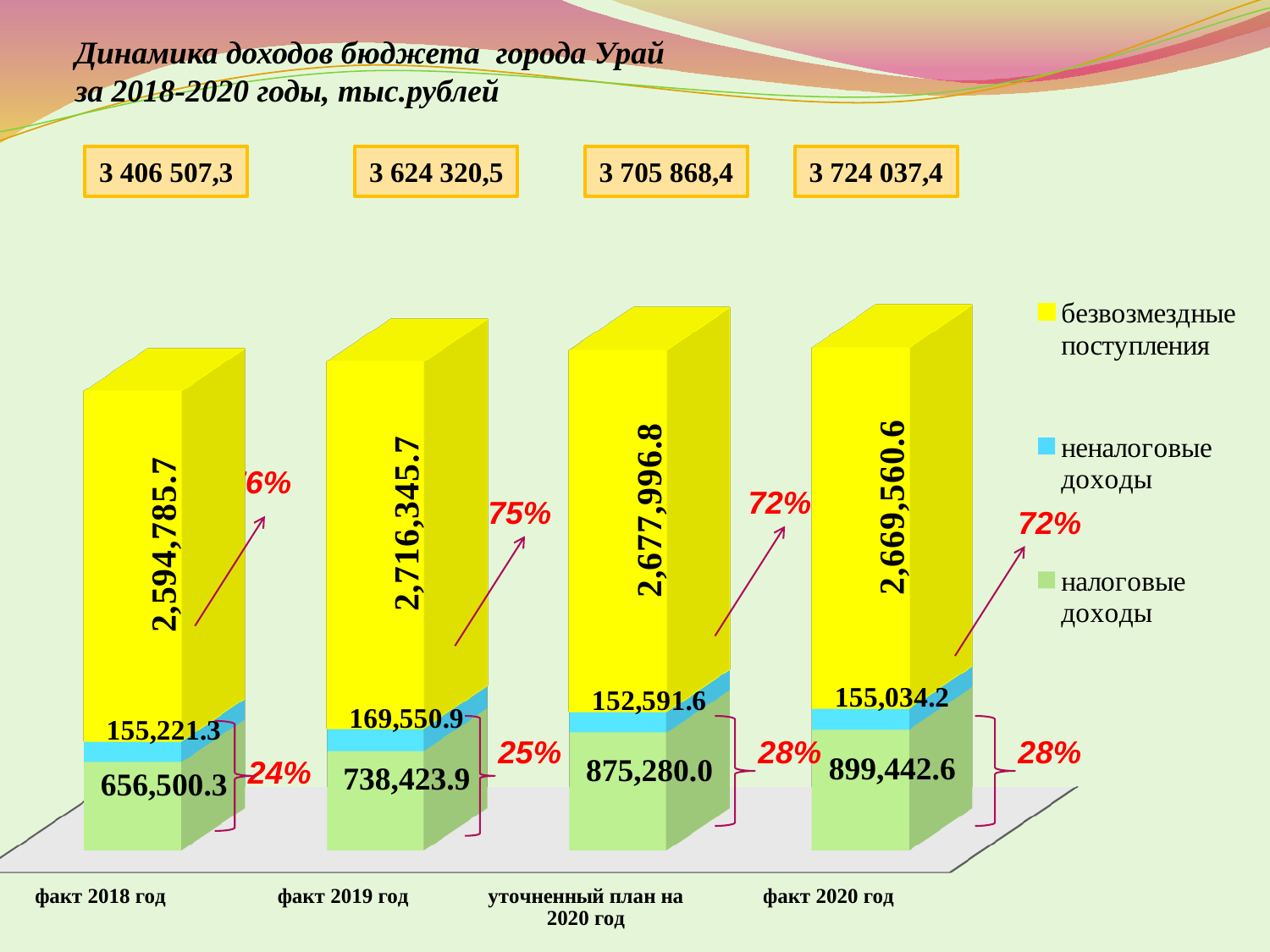
What share of the budget revenue do налоговые доходы make up in факт 2020 год, according to the label on the chart? 28% What is the value of налоговые доходы for факт 2020 год? 899,442.6 What is the value of неналоговые доходы for факт 2019 год? 169,550.9 How many categories (bars) are shown on the x axis? 4 What is the value of налоговые доходы for факт 2018 год? 656,500.3 How many series does the legend list? 3 Which category has the highest value of налоговые доходы? факт 2020 год Which category has the lowest value of безвозмездные поступления? факт 2018 год Which is larger: неналоговые доходы for факт 2018 год or for уточненный план на 2020 год? факт 2018 год What type of chart is shown on the slide? stacked bar chart What is the difference in налоговые доходы between факт 2020 год and факт 2019 год? 161,018.7 What is the value of безвозмездные поступления for уточненный план на 2020 год? 2,677,996.8